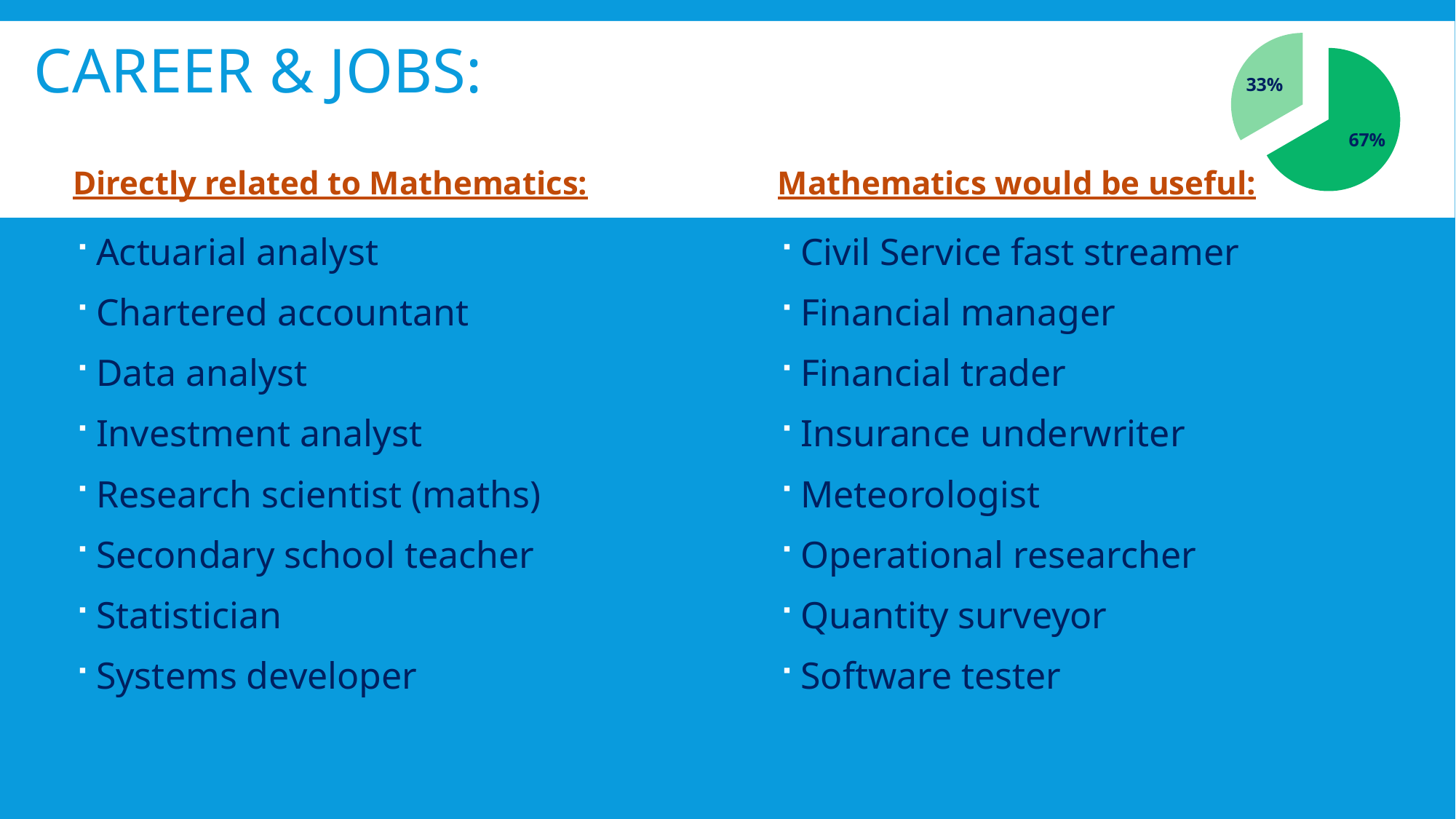
What share of the pie does the light green slice represent? 33% How many slices does the pie chart have? 2 Which slice of the pie chart is the largest? the dark green slice (67%) What is the difference in percentage points between the two slices of the pie chart? 34 percentage points Is the value of the dark green slice of the pie chart greater or less than 50%? greater What kind of chart is shown in the top right corner of the slide? pie chart Is the dark green slice or the light green slice of the pie chart larger? the dark green slice What percentage is shown on the light green slice of the pie chart? 33% Does the pie chart have a legend? No What percentage is shown on the dark green slice of the pie chart? 67% Which slice of the pie chart is the smallest? the light green slice (33%)